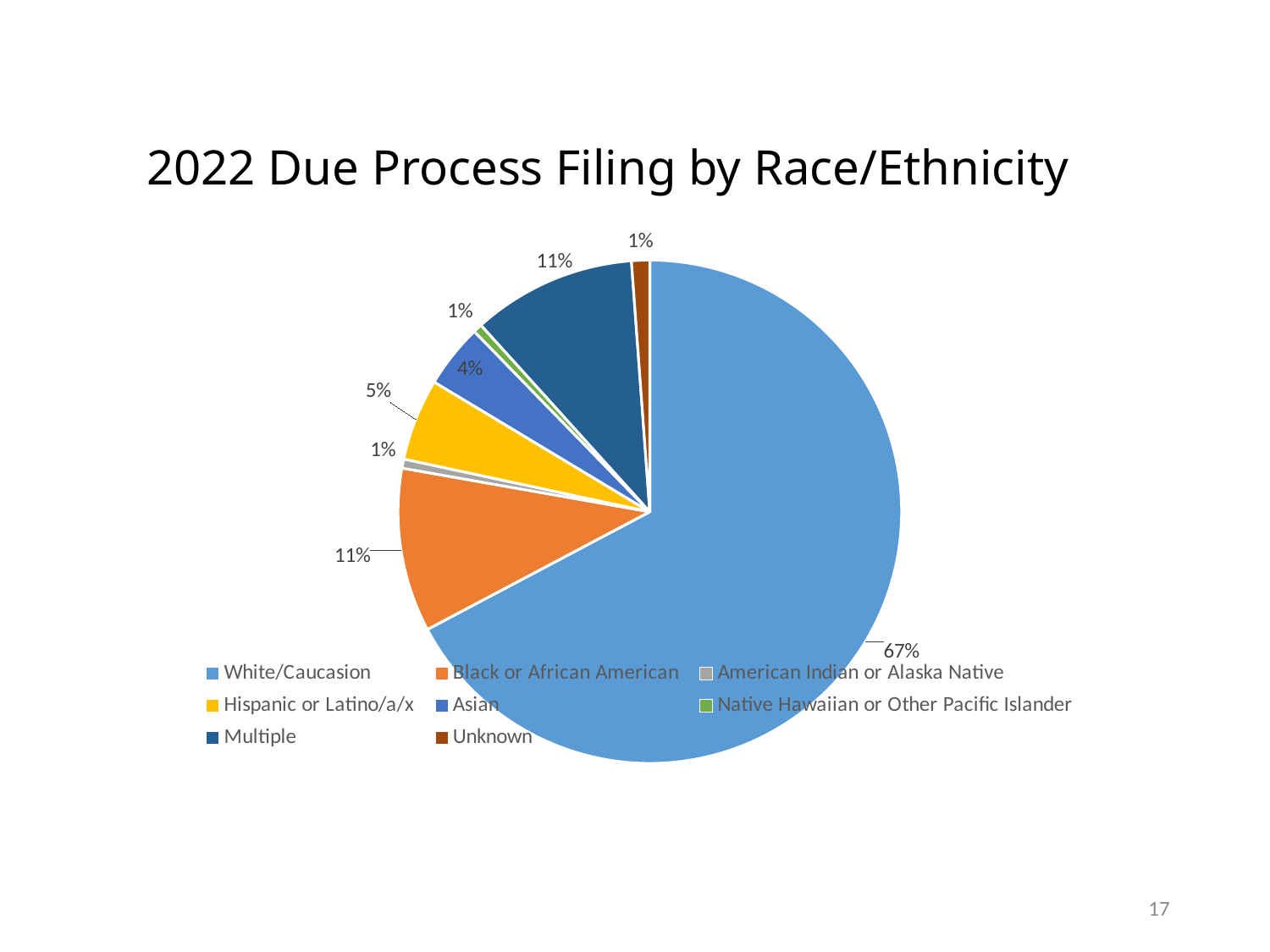
What share of the pie does White/Caucasion represent? 67% What is the difference between the White/Caucasion share and the Black or African American share? 56% How many categories does the legend list? 8 Which category has the largest slice of the pie? White/Caucasion What kind of chart is shown on the slide? Pie chart What colour is the Unknown slice in the legend? Brown What percentage is shown for Multiple? 11% What percentage is shown for Hispanic or Latino/a/x? 5% What percentage is shown for Black or African American? 11% What percentage is shown for Asian? 4% What is the title of the chart? 2022 Due Process Filing by Race/Ethnicity Which is larger, the Hispanic or Latino/a/x slice or the Asian slice? Hispanic or Latino/a/x